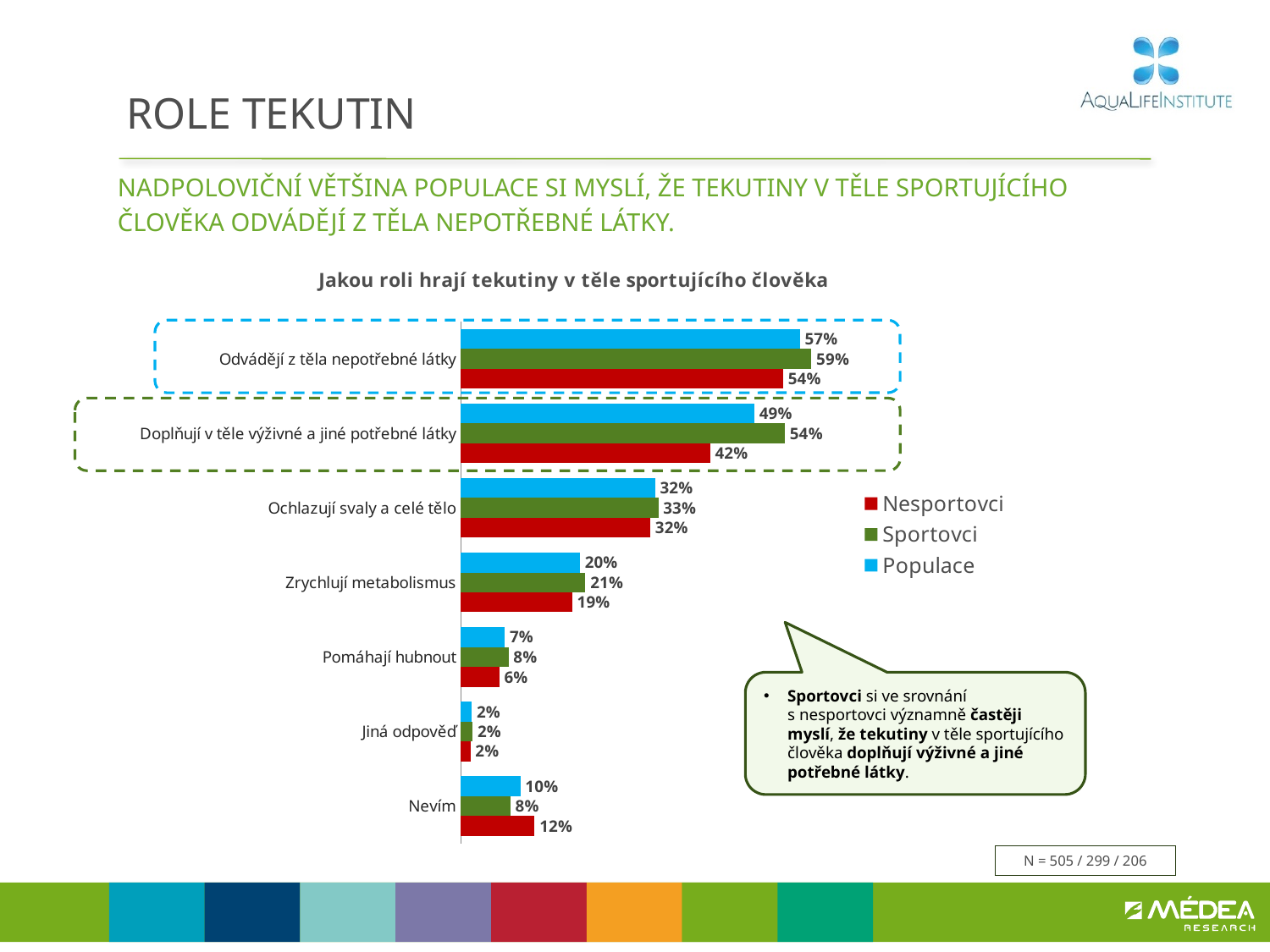
What is the difference between the Sportovci and Nesportovci values for 'Doplňují v těle výživné a jiné potřebné látky'? 12% In the category 'Nevím', which is larger: the value for Nesportovci or for Sportovci? Nesportovci What is the value for Sportovci in the category 'Doplňují v těle výživné a jiné potřebné látky'? 54% What is the value for Populace in the category 'Zrychlují metabolismus'? 20% Which category has the highest value for Populace? Odvádějí z těla nepotřebné látky Which category has the lowest value for Sportovci? Jiná odpověď What type of chart is shown on the slide? bar chart What is the title of the chart? Jakou roli hrají tekutiny v těle sportujícího člověka What is the difference between the Populace values for 'Odvádějí z těla nepotřebné látky' and 'Ochlazují svaly a celé tělo'? 25% How many series does the legend list? 3 What is the value for Nesportovci in the category 'Nevím'? 12% How many categories are shown on the chart? 7